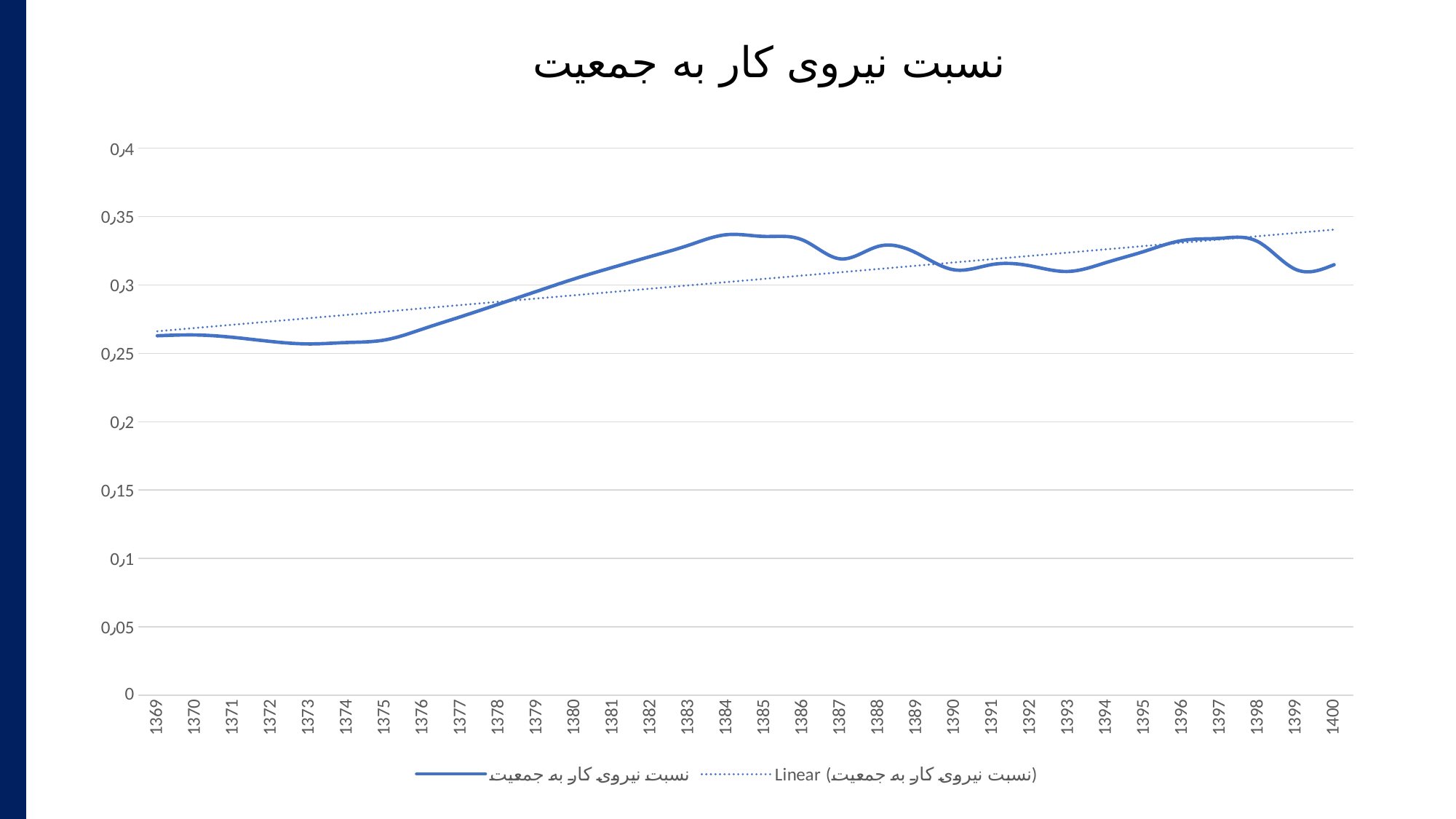
What is the first year shown on the x axis? 1369 Is the value for 1369 greater or less than 0,3? less What is the title of the chart? نسبت نیروی کار به جمعیت Is the value for 1373 greater or less than 0,25? greater What kind of chart is shown on the slide? line chart How many years are shown on the x axis? 32 Is the value for 1384 greater or less than 0,3? greater Which year has the larger value, 1369 or 1384? 1384 Does the dotted linear trendline rise or fall from 1369 to 1400? rise Which year has the larger value, 1373 or 1380? 1380 How many series does the legend list? 2